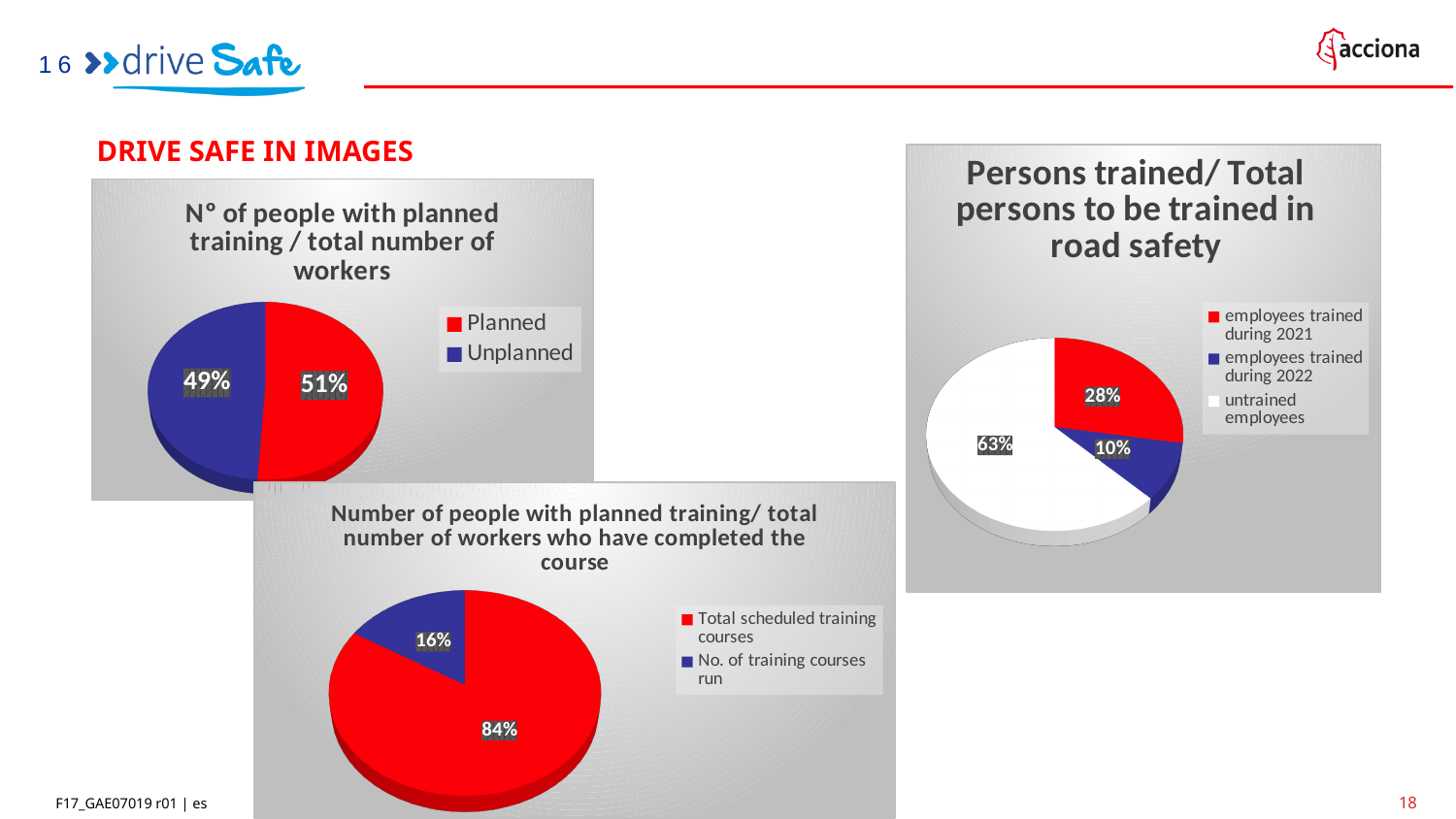
In the chart titled "Number of people with planned training/ total number of workers who have completed the course", what share is No. of training courses run? 16% In the chart titled "Persons trained/ Total persons to be trained in road safety", what share is employees trained during 2021? 28% In the chart titled "Number of people with planned training/ total number of workers who have completed the course", what share is Total scheduled training courses? 84% What kind of chart is the one titled "N° of people with planned training / total number of workers"? Pie chart In the chart titled "Number of people with planned training/ total number of workers who have completed the course", what is the difference in percentage points between the two slices? 68 In the chart titled "N° of people with planned training / total number of workers", what share is Planned? 51% In the chart titled "Persons trained/ Total persons to be trained in road safety", what colour is the untrained employees slice? White In the chart titled "N° of people with planned training / total number of workers", what share is Unplanned? 49% In the chart titled "Persons trained/ Total persons to be trained in road safety", what share is employees trained during 2022? 10% In the chart titled "Persons trained/ Total persons to be trained in road safety", how many categories does the legend list? 3 In the chart titled "N° of people with planned training / total number of workers", which slice is larger, Planned or Unplanned? Planned In the chart titled "Persons trained/ Total persons to be trained in road safety", which category has the largest slice? untrained employees